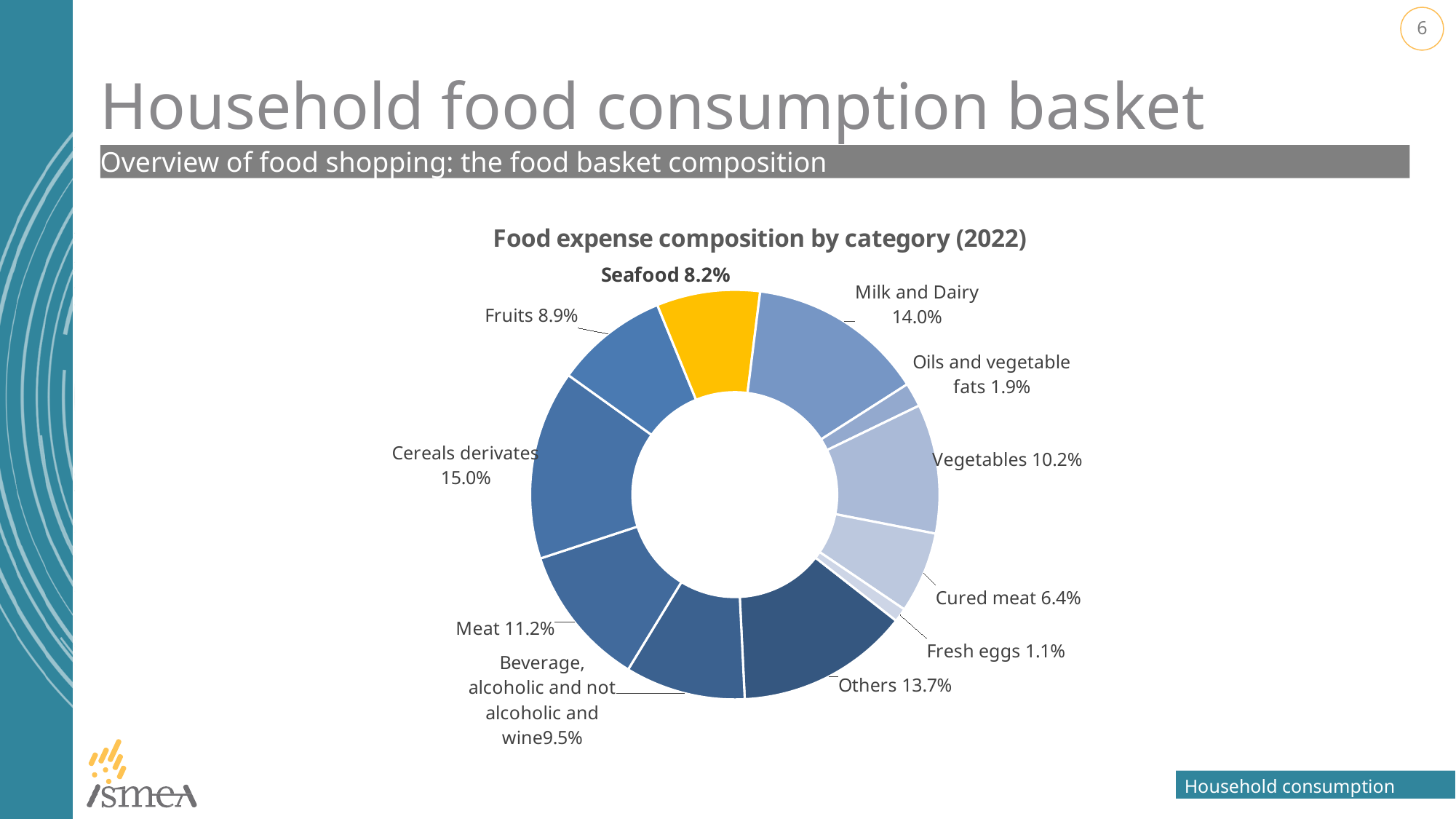
Which is larger, the share for Vegetables or the share for Fruits? Vegetables What percentage is shown for Milk and Dairy? 14.0% What is the difference between the shares of Meat and Cured meat? 4.8% What is the value for Fresh eggs? 1.1% Which category has the largest share of food expense? Cereals derivates What kind of chart is shown on the slide? Doughnut chart What is the value shown for Cereals derivates? 15.0% What share of food expense does Seafood account for? 8.2% Which category has the smallest share of food expense? Fresh eggs What is the difference between the shares of Cereals derivates and Milk and Dairy? 1.0% What is the title of the chart? Food expense composition by category (2022) How many categories are shown in the chart? 11